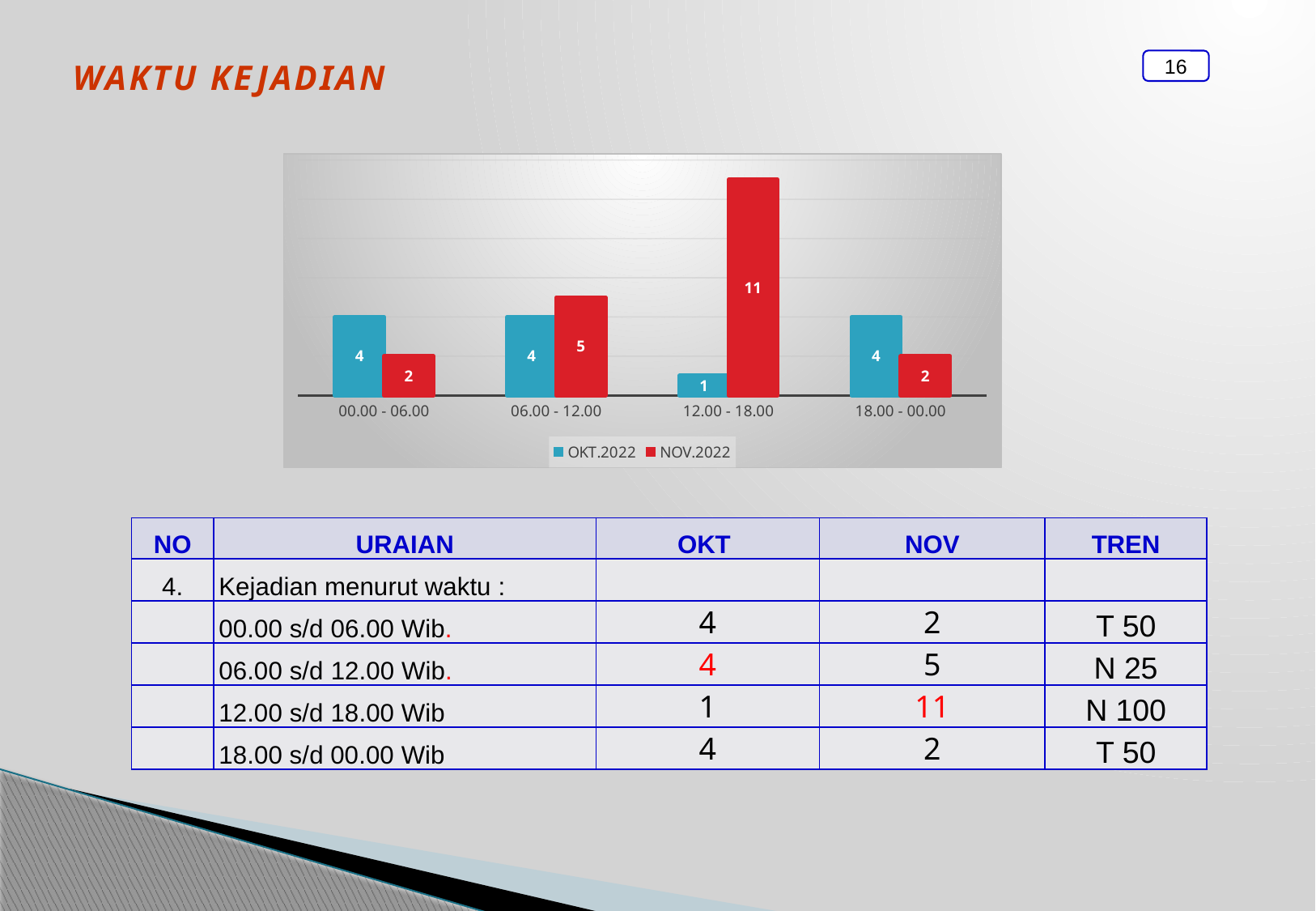
What is the difference between the NOV.2022 and OKT.2022 values in the 12.00 - 18.00 category? 10 What is the value for OKT.2022 in the 12.00 - 18.00 category? 1 What is the value for NOV.2022 in the 12.00 - 18.00 category? 11 Which category has the highest NOV.2022 value? 12.00 - 18.00 How many categories are shown on the x axis of the chart? 4 In the 06.00 - 12.00 category, which series has the larger value, OKT.2022 or NOV.2022? NOV.2022 What type of chart is shown on the slide? Bar chart Which colour represents the NOV.2022 series in the chart? Red What is the value for NOV.2022 in the 00.00 - 06.00 category? 2 How many series does the chart legend list? 2 What is the value for OKT.2022 in the 06.00 - 12.00 category? 4 Which category has the lowest OKT.2022 value? 12.00 - 18.00